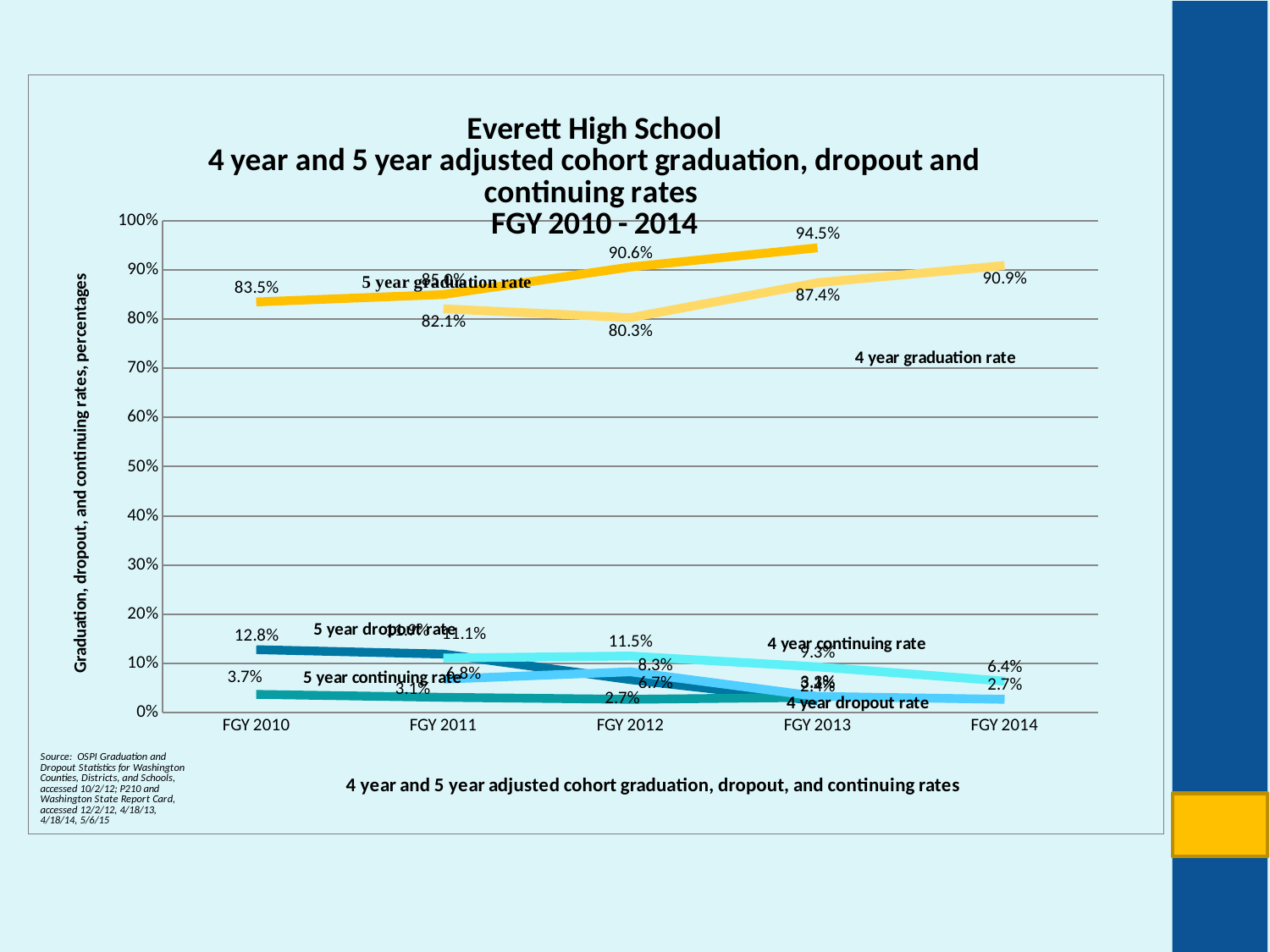
What is the 5 year dropout rate for FGY 2010? 12.8% What is the 5 year graduation rate for FGY 2013? 94.5% In which year is the 5 year graduation rate highest? FGY 2013 In which year is the 4 year graduation rate lowest? FGY 2012 What is the 5 year graduation rate for FGY 2010? 83.5% What is the 4 year graduation rate for FGY 2012? 80.3% What kind of chart is shown on the slide? Line chart For FGY 2013, which is larger: the 4 year graduation rate or the 5 year graduation rate? 5 year graduation rate How many FGY categories are shown on the x axis? 5 Is the 4 year graduation rate for FGY 2011 greater or less than 90%? less What is the 4 year graduation rate for FGY 2014? 90.9% By how many percentage points did the 5 year graduation rate change from FGY 2010 to FGY 2013? 11.0 percentage points